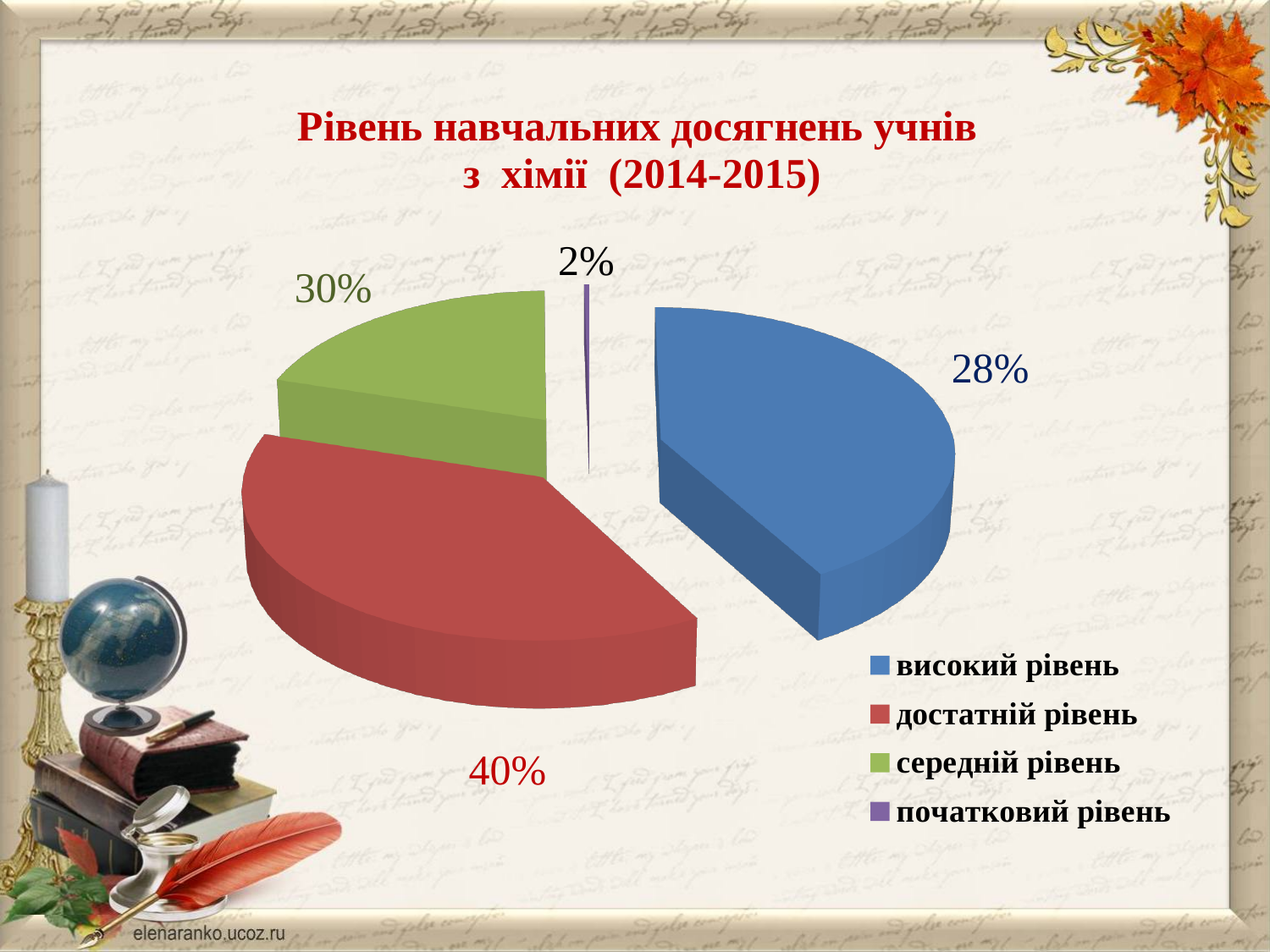
What share of the pie is середній рівень? 30% Which level has the smallest share of the pie? початковий рівень Which is larger, the share for середній рівень or the share for високий рівень? середній рівень What is the difference in percentage points between достатній рівень and високий рівень? 12 What percentage of students reached the достатній рівень? 40% What colour is the slice for достатній рівень? red What percentage is shown for високий рівень? 28% What type of chart is shown on the slide? pie chart How many entries does the legend list? 4 What percentage is shown for початковий рівень? 2% How many slices does the pie chart have? 4 Which level has the largest share of the pie? достатній рівень